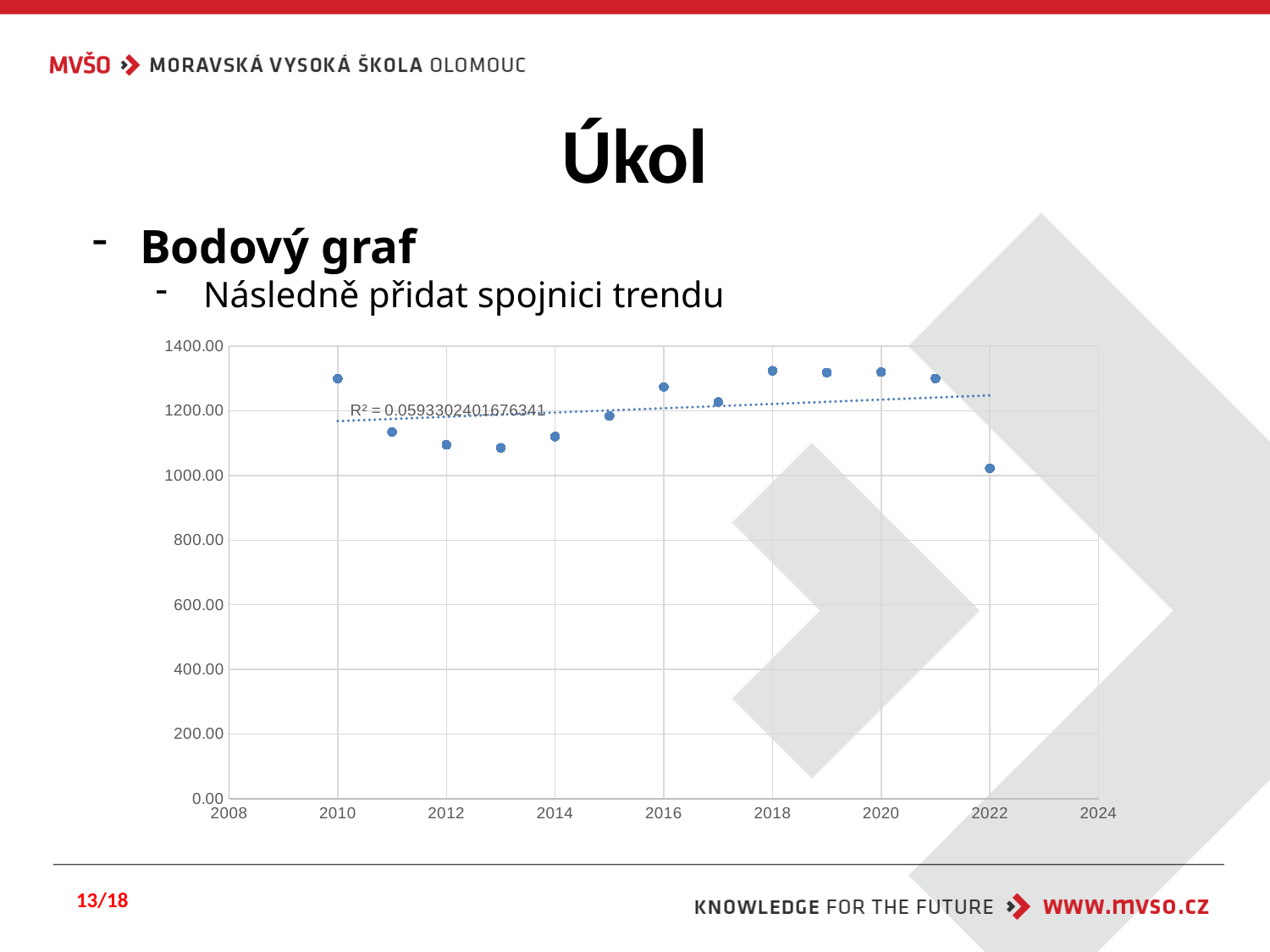
Which year has the lowest plotted value? 2022 What R² value is printed on the chart? R² = 0.0593302401676341 How many data points are plotted in the chart? 13 Is the value for 2010 greater or less than 1200? greater What kind of chart is shown on the slide? scatter chart Is the value for 2013 greater or less than 1000? greater What is the highest value shown on the vertical axis? 1400.00 Which is larger, the value for 2010 or the value for 2012? 2010 Which is larger, the value for 2013 or the value for 2016? 2016 Is the value for 2022 greater or less than 1200? less